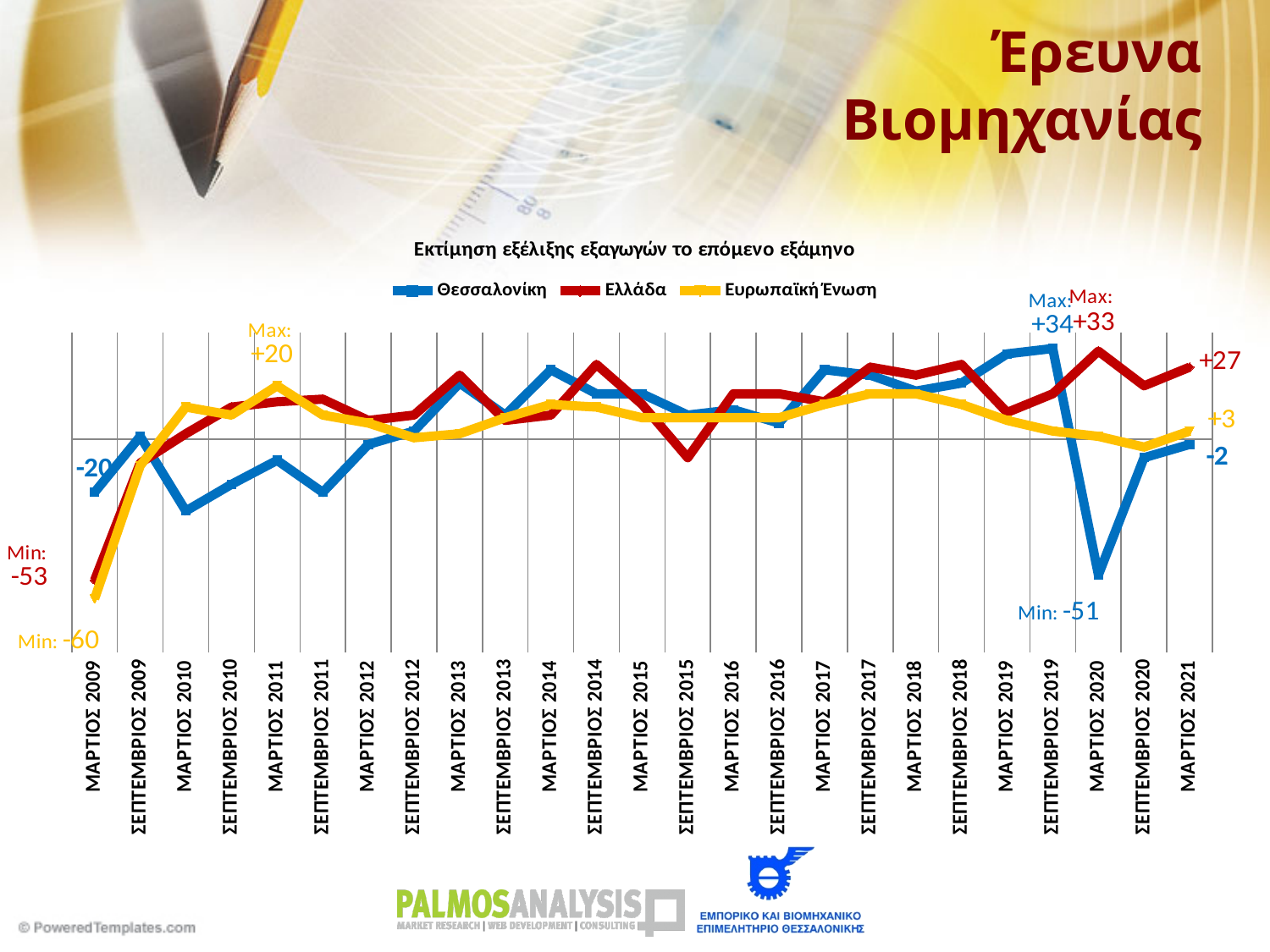
What is the minimum value reached by the Θεσσαλονίκη series? -51 What is the value for Θεσσαλονίκη in ΜΑΡΤΙΟΣ 2009? -20 What is the value for Ευρωπαϊκή Ένωση in ΜΑΡΤΙΟΣ 2021? +3 What is the minimum value reached by the Ευρωπαϊκή Ένωση series? -60 How many series does the chart legend list? 3 What is the value for Θεσσαλονίκη in ΜΑΡΤΙΟΣ 2021? -2 What is the difference between the Ελλάδα value (+27) and the Ευρωπαϊκή Ένωση value (+3) in ΜΑΡΤΙΟΣ 2021? 24 Which series has the higher value in ΜΑΡΤΙΟΣ 2021, Ελλάδα or Θεσσαλονίκη? Ελλάδα What is the title of the chart? Εκτίμηση εξέλιξης εξαγωγών το επόμενο εξάμηνο What is the maximum value reached by the Θεσσαλονίκη series, and in which period? +34, ΣΕΠΤΕΜΒΡΙΟΣ 2019 What is the value for Ελλάδα in ΜΑΡΤΙΟΣ 2021? +27 What kind of chart is shown on the slide? line chart